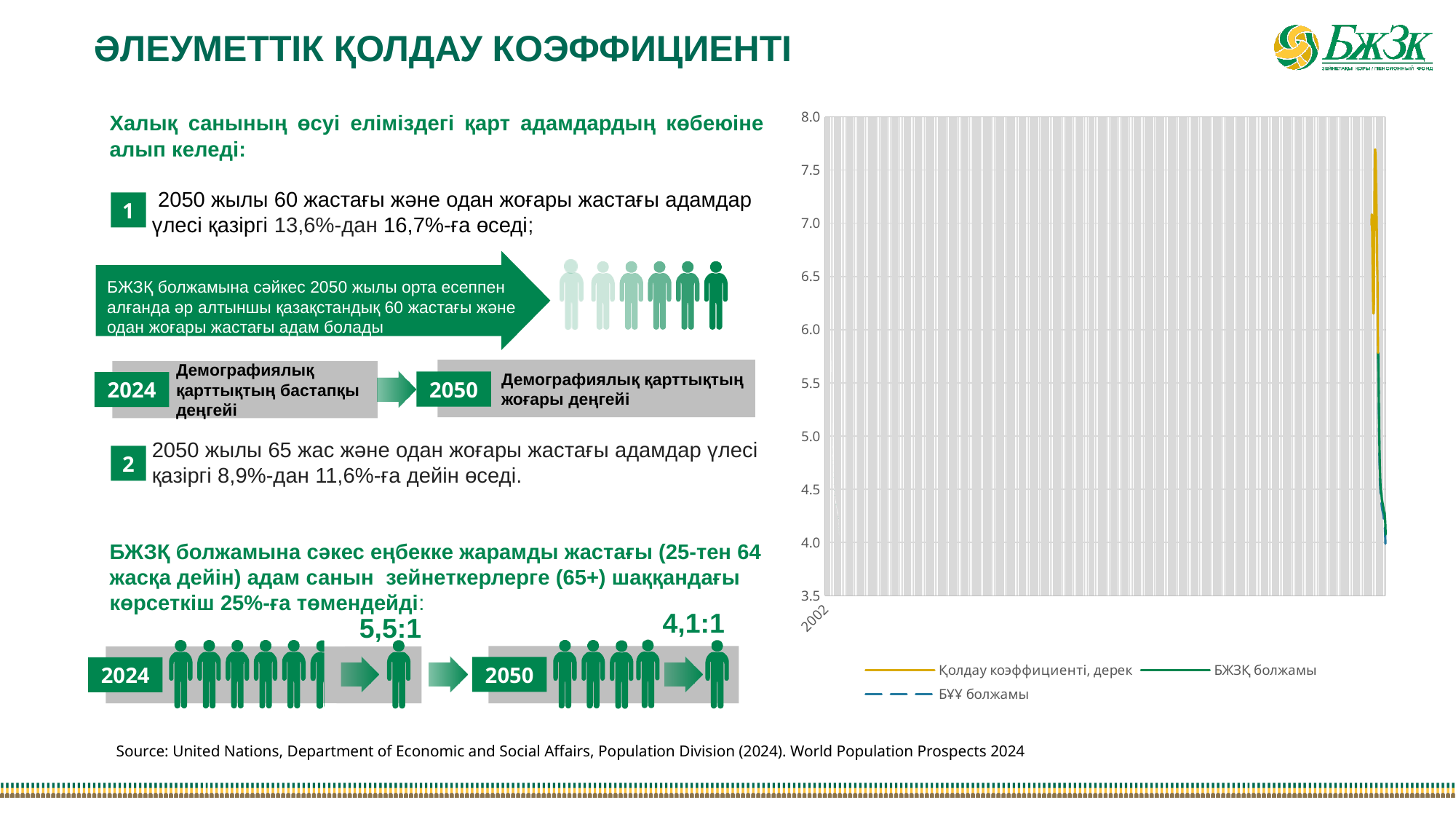
Which series in the chart legend is drawn with a dashed line? БҰҰ болжамы What is the first year label shown on the horizontal axis of the chart? 2002 What colour is the line for the series 'Қолдау коэффициенті, дерек' in the chart? yellow How many series does the legend of the chart list? 3 What kind of chart is shown on the right side of the slide? line chart Is the final value of the 'БЖЗҚ болжамы' line greater or less than 4.5? less